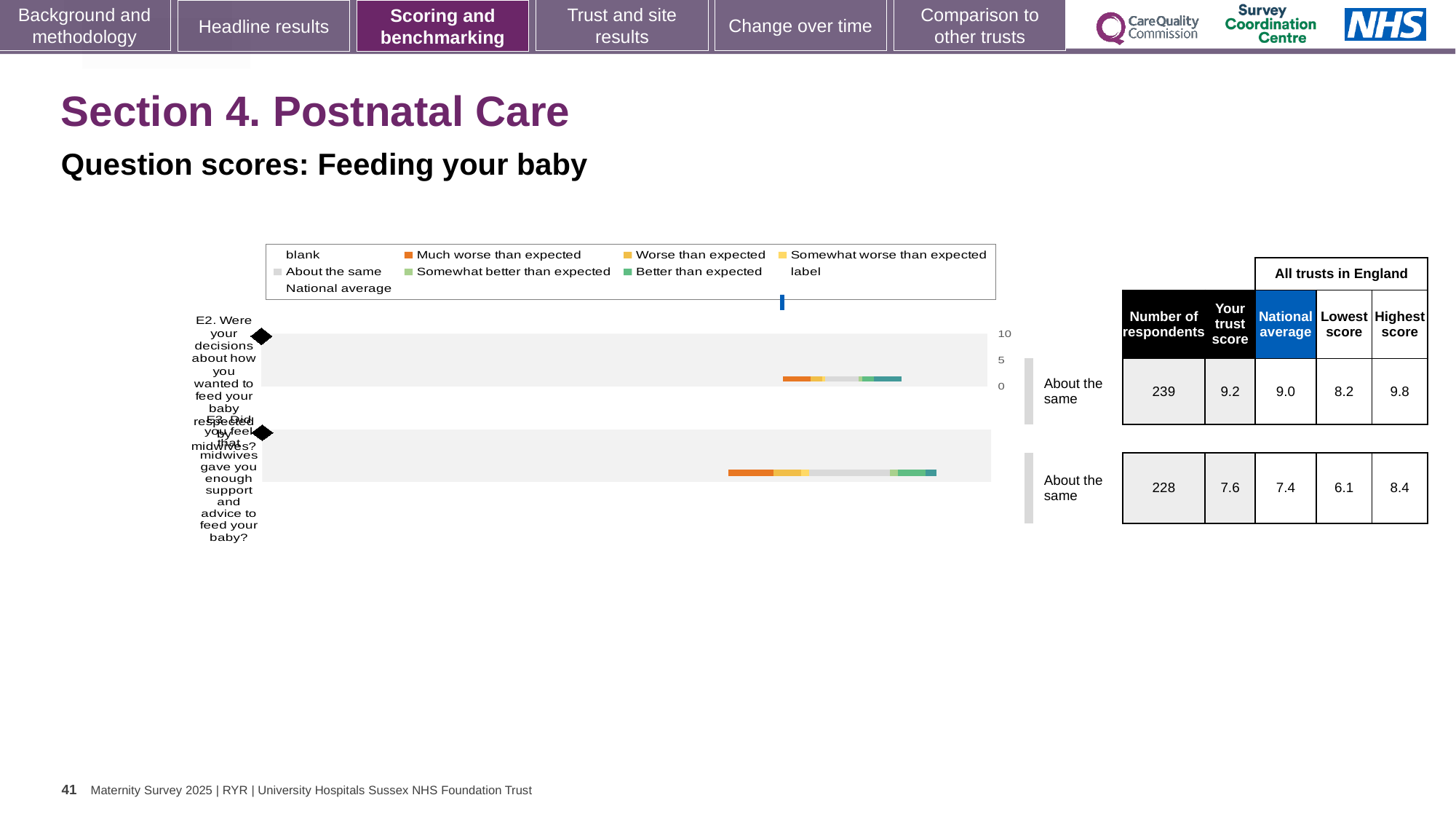
How many survey questions are plotted as bars in the chart? 2 What is the national average for question E3 (midwives gave you enough support and advice to feed your baby)? 7.4 What is the lowest score across all trusts in England for question E3? 6.1 What colour does the legend use for 'Much worse than expected'? orange How many respondents answered question E2? 239 What benchmark category is shown for question E3? About the same What kind of chart is shown on the slide? bar chart Which question has the higher trust score, E2 or E3? E2 What is the 'Your trust score' for question E2 (decisions about how you wanted to feed your baby respected by midwives)? 9.2 What is the subtitle describing the chart on the slide? Question scores: Feeding your baby What is the difference between the highest score and the lowest score for question E2? 1.6 By how much does the trust score for question E3 exceed the national average? 0.2